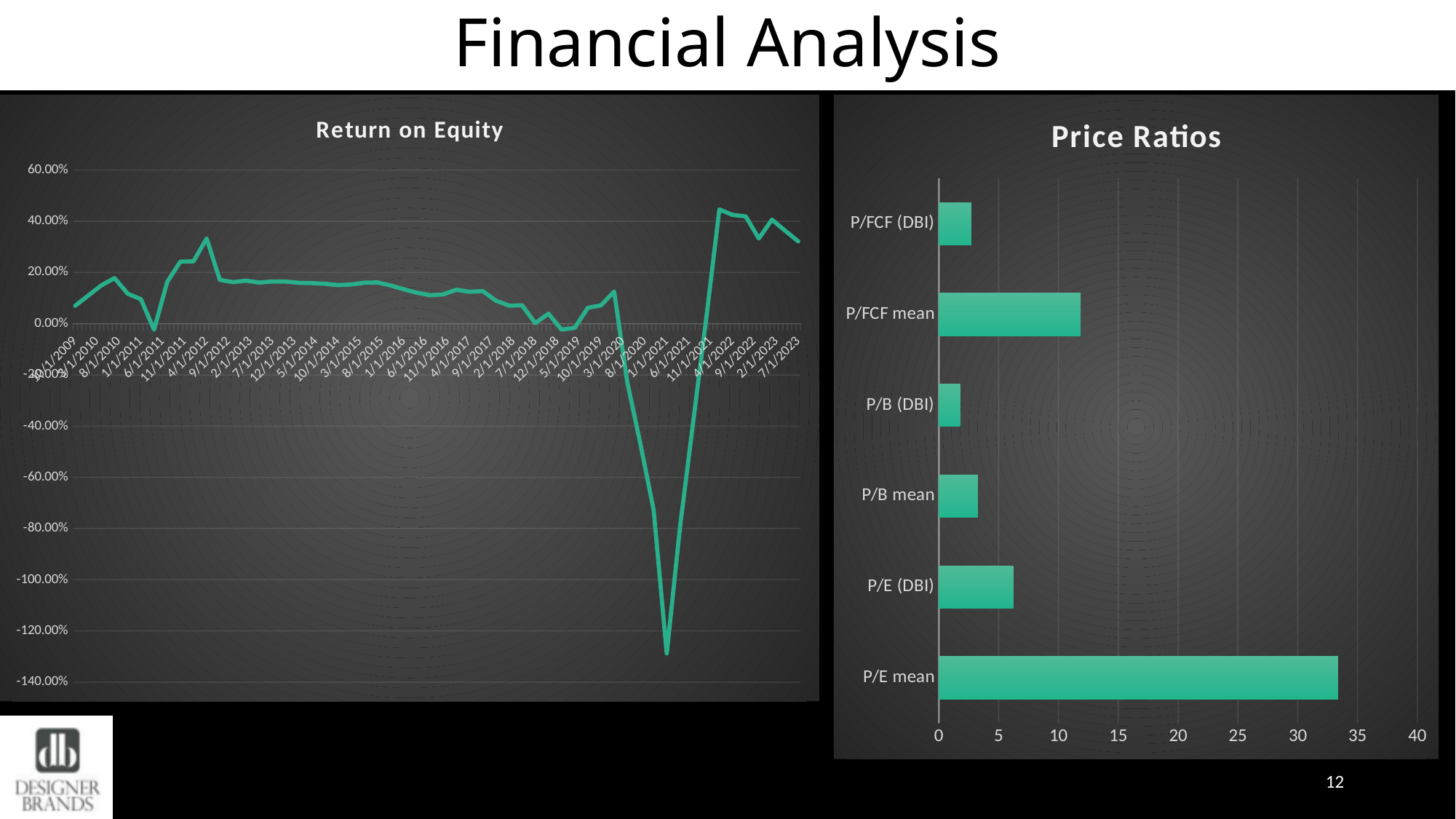
In the Price Ratios chart, which is larger, P/FCF mean or P/B mean? P/FCF mean What type of chart is the Return on Equity chart? line chart In the Price Ratios chart, is the value for P/FCF mean greater or less than 10? greater What type of chart is the Price Ratios chart? bar chart What is the title of the chart on the right side of the slide? Price Ratios In the Price Ratios chart, which category has the highest value? P/E mean In the Return on Equity chart, is the value at 7/1/2023 greater or less than 20.00%? greater In the Price Ratios chart, is the value for P/E mean greater or less than 30? greater In the Price Ratios chart, which is larger, P/E mean or P/E (DBI)? P/E mean In the Price Ratios chart, how many categories are shown? 6